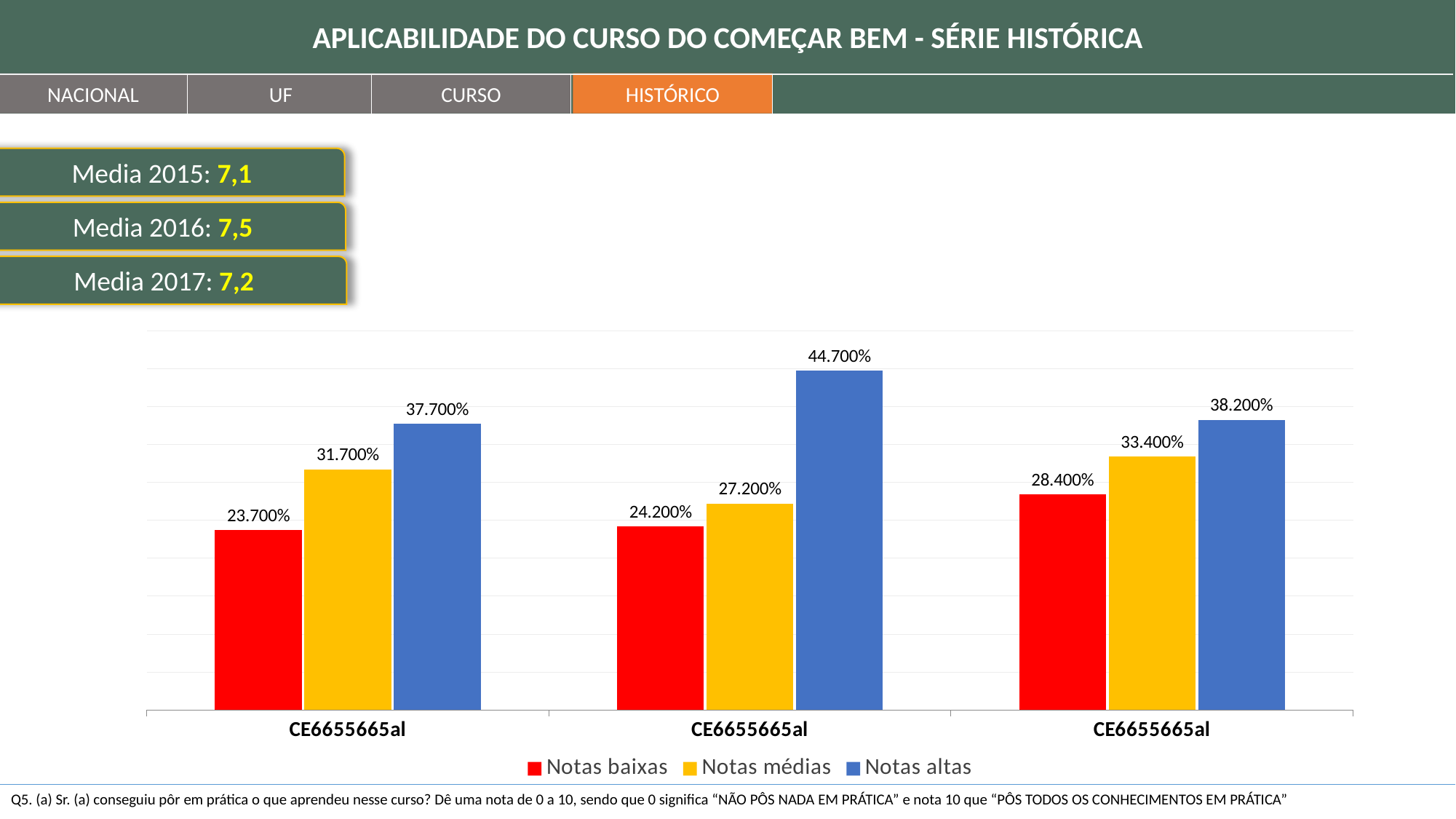
Which is larger: the Notas médias value in the leftmost group or the Notas médias value in the middle group? leftmost group (31.700%) Do the Notas baixas values rise or fall from the leftmost group to the rightmost group? rise How many groups of bars are plotted along the x axis? 3 Which colour represents the Notas altas series in the chart? blue What is the value of the Notas altas bar in the middle group? 44.700% What is the value of the Notas médias bar in the rightmost group? 33.400% How many series does the chart legend list? 3 Which series has the highest bar in the middle group? Notas altas What is the difference between the Notas altas and Notas baixas values in the middle group? 20.500% Which series has the lowest bar in the rightmost group? Notas baixas What type of chart is shown on the slide? bar chart What is the value of the Notas baixas bar in the leftmost group? 23.700%